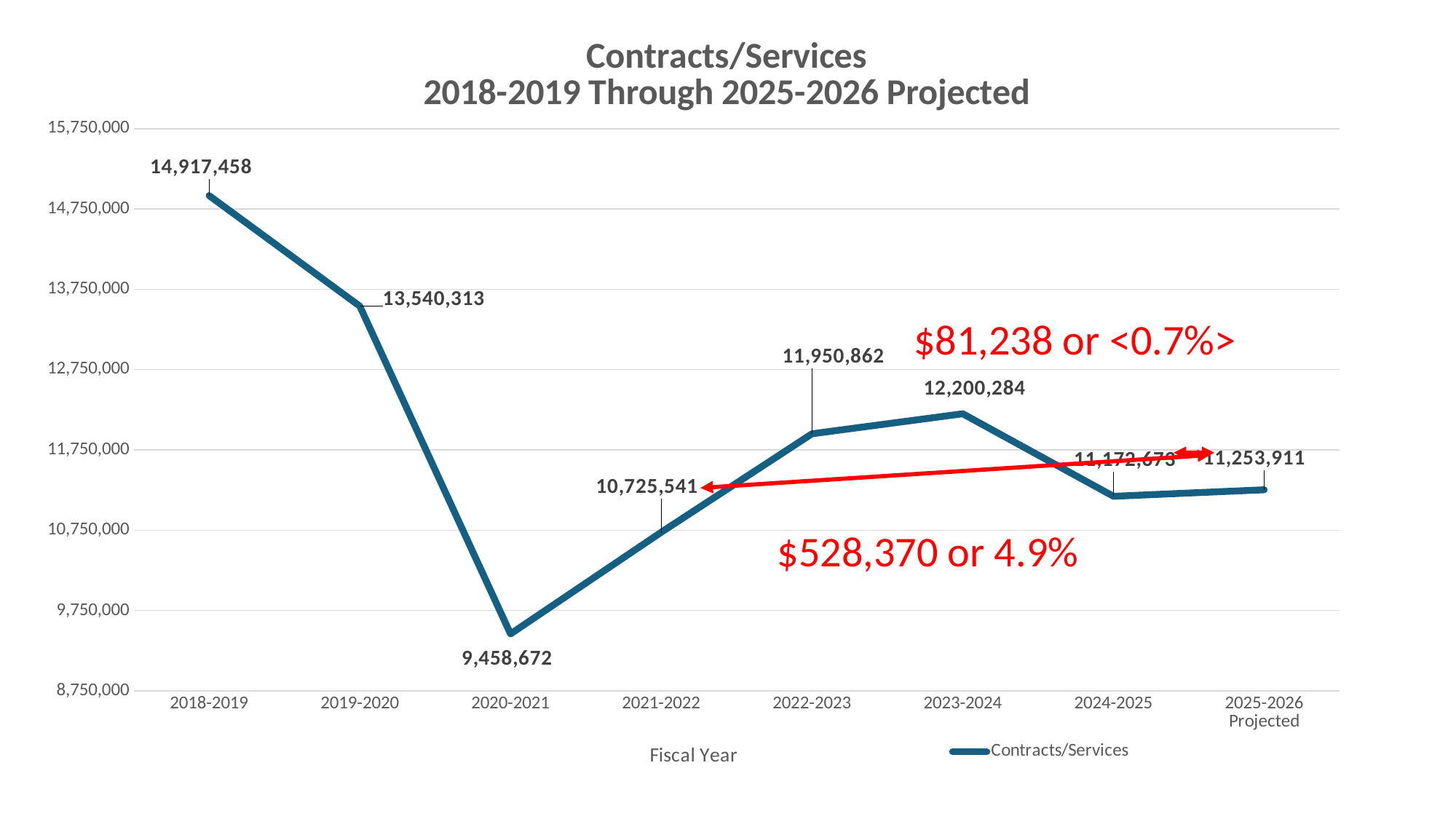
What kind of chart is shown on the slide? line chart How many fiscal years are plotted on the chart? 8 What is the difference between the 2023-2024 value and the 2022-2023 value? 249,422 Which fiscal year has the lowest Contracts/Services value? 2020-2021 Which is larger, the value for 2021-2022 or the value for 2023-2024? 2023-2024 Is the value for 2024-2025 greater or less than 11,750,000? less What is the difference between the 2018-2019 value and the 2019-2020 value? 1,377,145 What is the Contracts/Services value for 2022-2023? 11,950,862 Which fiscal year has the highest Contracts/Services value? 2018-2019 What is the Contracts/Services value for 2018-2019? 14,917,458 What is the Contracts/Services value for 2020-2021? 9,458,672 What is the projected Contracts/Services value for 2025-2026? 11,253,911